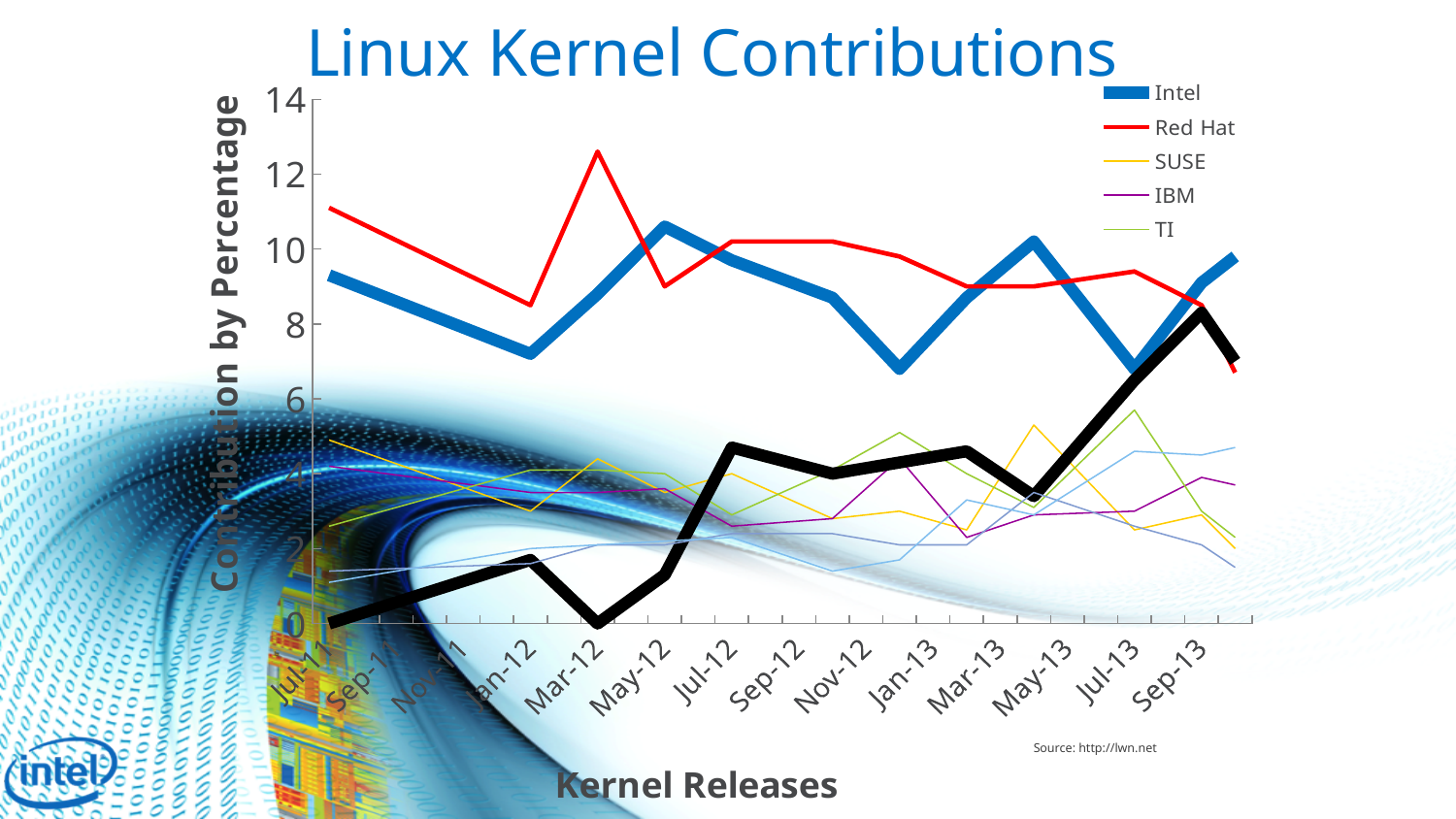
Is the value for Red Hat at Mar-12 greater or less than 12? greater Is the value for Intel at Jan-13 greater or less than 8? less Does the value for Red Hat rise or fall from Jul-11 to Jan-12? Fall At Mar-12, which is larger, the value for Red Hat or the value for Intel? Red Hat What is the title of the y axis? Contribution by Percentage Is the value for Red Hat at Jul-11 greater or less than 10? greater At which kernel release does Red Hat reach its highest value? Mar-12 How many series does the legend list? 5 What kind of chart is shown on the slide? Line chart